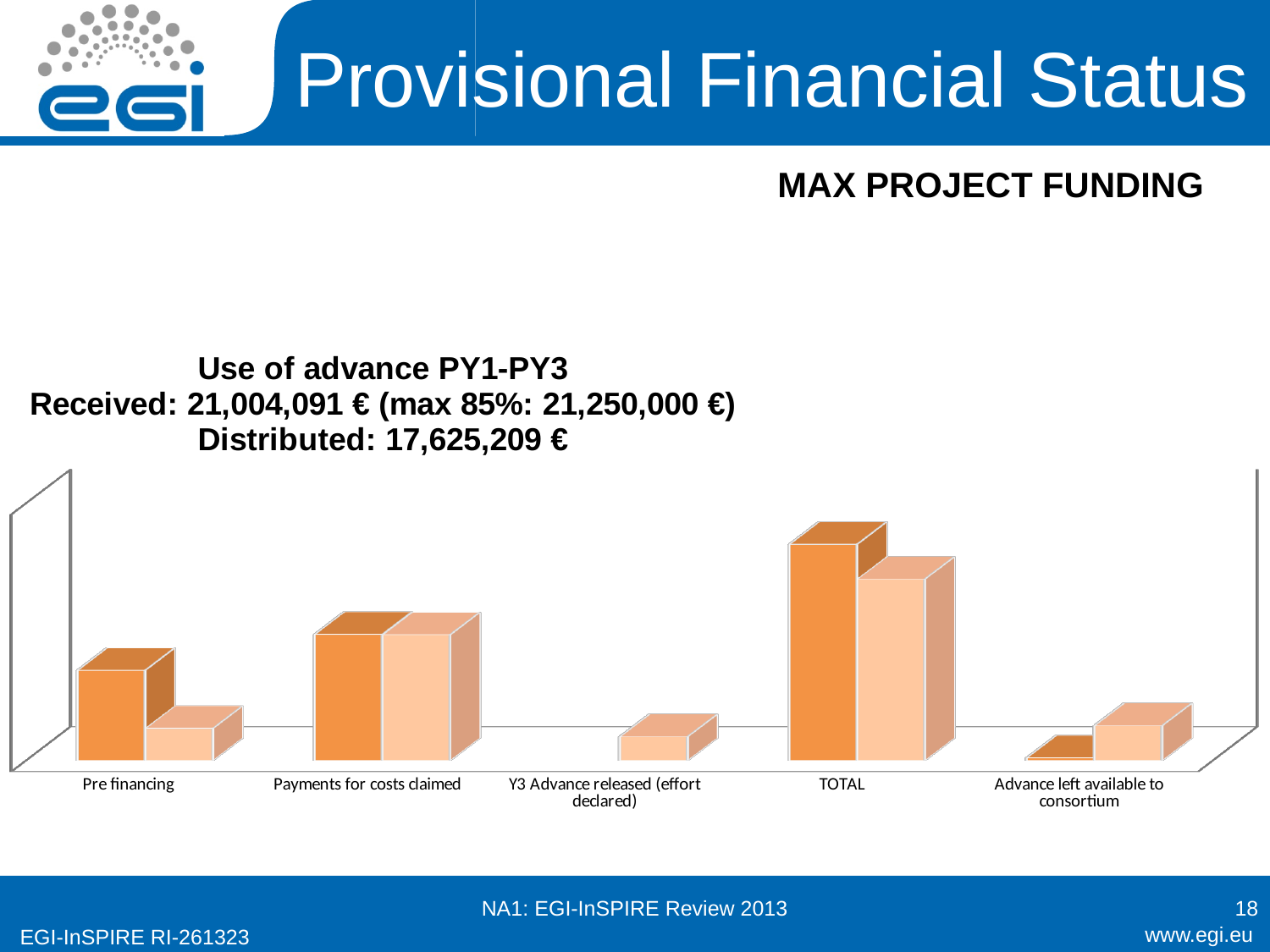
What kind of chart is shown on the slide? bar chart For Advance left available to consortium, which bar is taller, the dark orange or the light orange one? light orange For TOTAL, which bar is taller, the dark orange or the light orange one? dark orange Which has the taller dark orange bar, Pre financing or Payments for costs claimed? Payments for costs claimed Which category has the smallest dark orange bar? Advance left available to consortium How many categories are shown on the x axis of the chart? 5 What is the label of the fourth category on the x axis? TOTAL Which category has the tallest dark orange bar? TOTAL How many bars are plotted for each category in the chart? 2 Which category has the tallest light orange bar? TOTAL